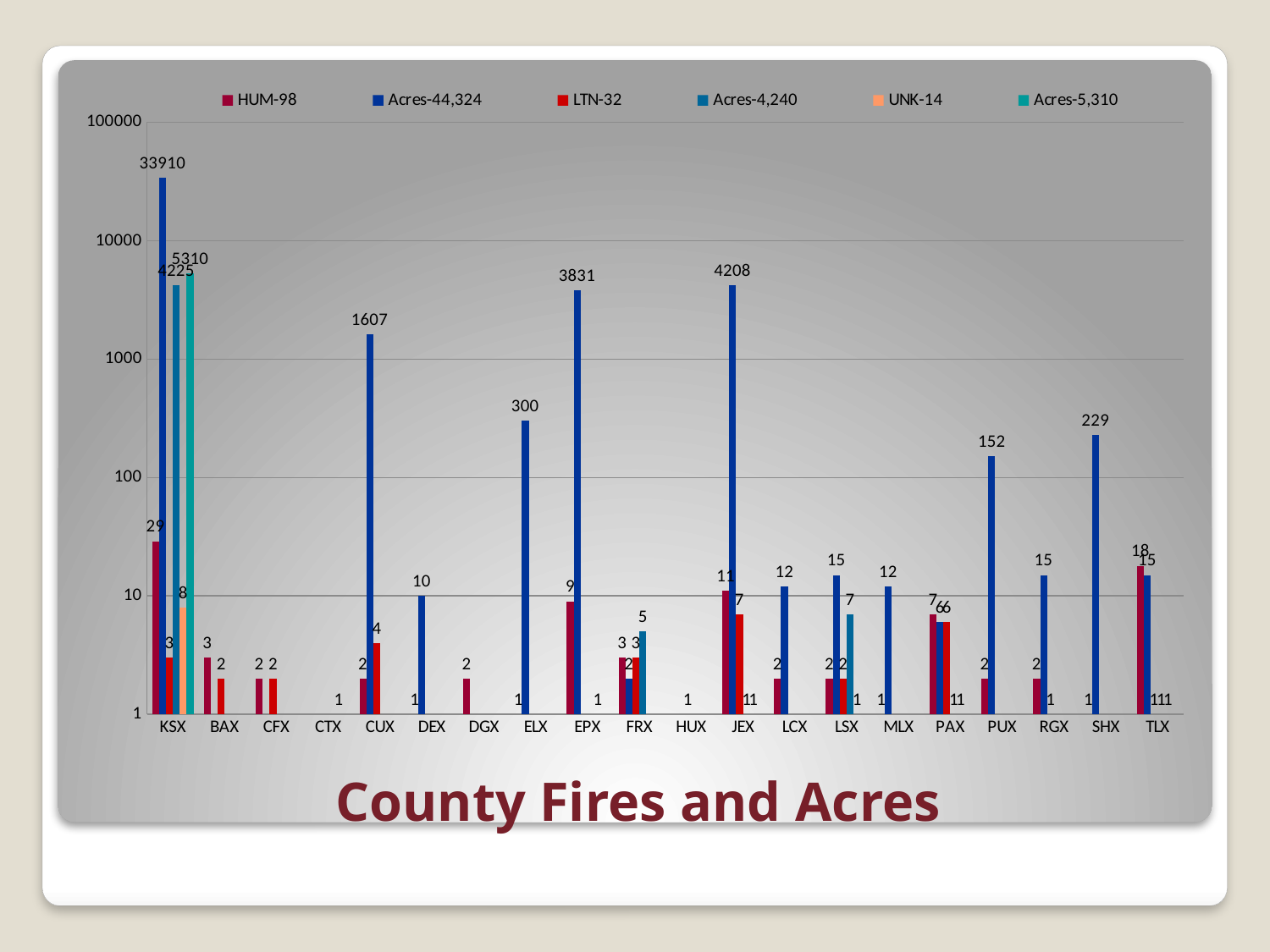
What is the title of the chart? County Fires and Acres What is the value of the Acres-44,324 series for KSX? 33910 How many series does the legend list? 6 What is the value of the UNK-14 series for KSX? 8 How many counties are shown on the x axis? 20 What is the value of the Acres-44,324 series for PUX? 152 Which is larger, the Acres-44,324 value for CUX or for ELX? CUX Which county has the highest value in the Acres-44,324 series? KSX What is the difference between the Acres-44,324 values for JEX and EPX? 377 Is the Acres-44,324 value for DEX greater or less than 100? less What is the value of the Acres-44,324 series for SHX? 229 What is the value of the HUM-98 series for KSX? 29